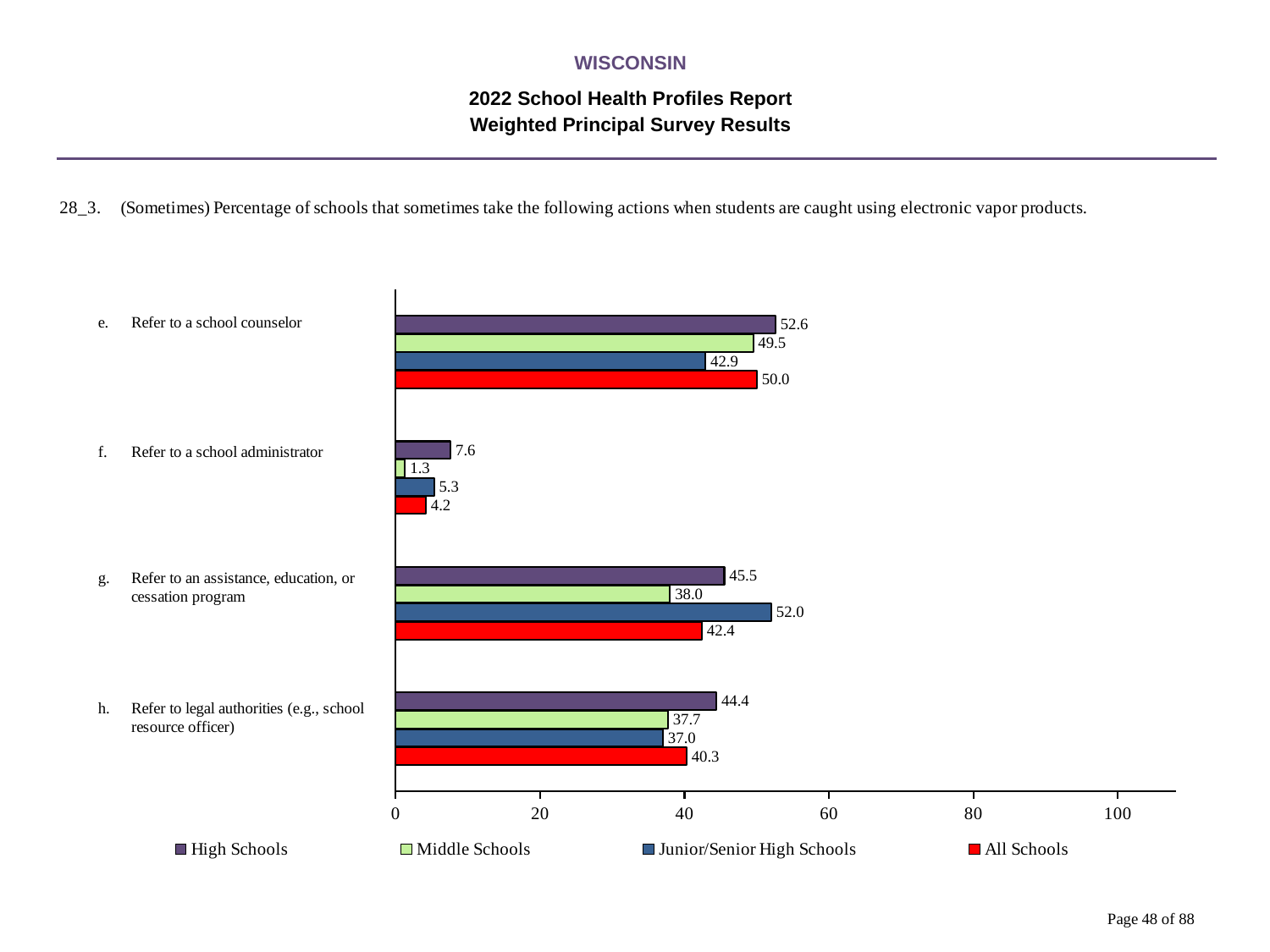
Which school type has the lowest value for 'Refer to a school administrator'? Middle Schools What is the value for Middle Schools for 'Refer to a school administrator'? 1.3 What is the difference between the High Schools and Middle Schools values for 'Refer to legal authorities (e.g., school resource officer)'? 6.7 For 'Refer to a school counselor', which is larger: the Middle Schools value or the Junior/Senior High Schools value? Middle Schools How many series does the legend list? 4 What is the value for High Schools for 'Refer to a school counselor'? 52.6 What kind of chart is shown on the slide? Bar chart What is the value for All Schools for 'Refer to legal authorities (e.g., school resource officer)'? 40.3 Is the All Schools value for 'Refer to a school counselor' greater or less than 40? greater Which school type has the highest value for 'Refer to an assistance, education, or cessation program'? Junior/Senior High Schools What is the value for Junior/Senior High Schools for 'Refer to an assistance, education, or cessation program'? 52.0 How many action categories are shown on the chart? 4